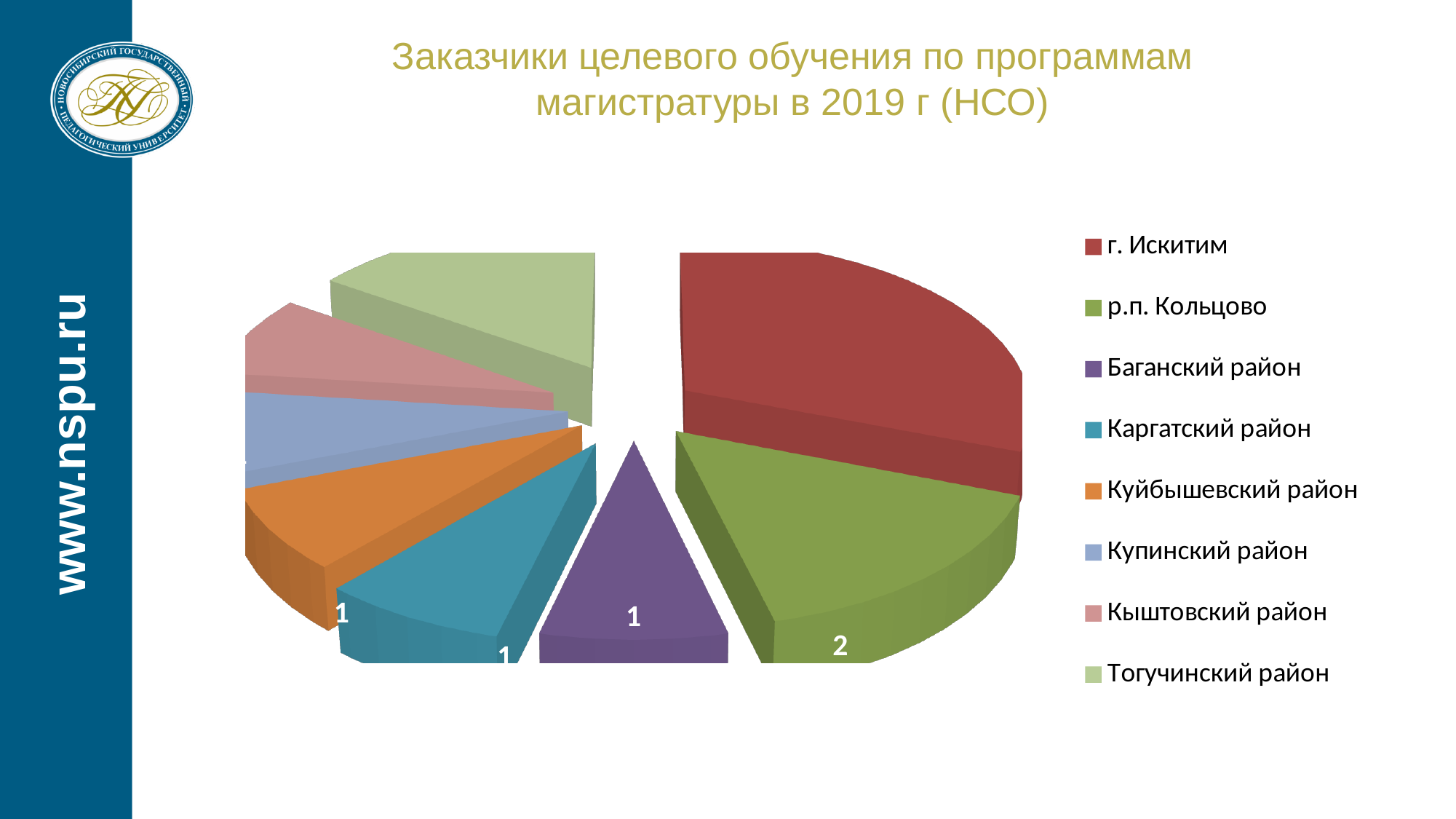
What is the title of the chart on the slide? Заказчики целевого обучения по программам магистратуры в 2019 г (НСО) What is the value for Куйбышевский район in the pie chart? 1 How many categories does the legend of the pie chart list? 8 What is the difference between the value for р.п. Кольцово and the value for Каргатский район? 1 What is the value for Каргатский район in the pie chart? 1 Which category is listed first in the legend of the pie chart? г. Искитим What kind of chart is shown on the slide? Pie chart What is the value for р.п. Кольцово in the pie chart? 2 Which category has the largest slice in the pie chart? г. Искитим Which is larger in the pie chart: the value for р.п. Кольцово or the value for Баганский район? р.п. Кольцово What is the value for Баганский район in the pie chart? 1